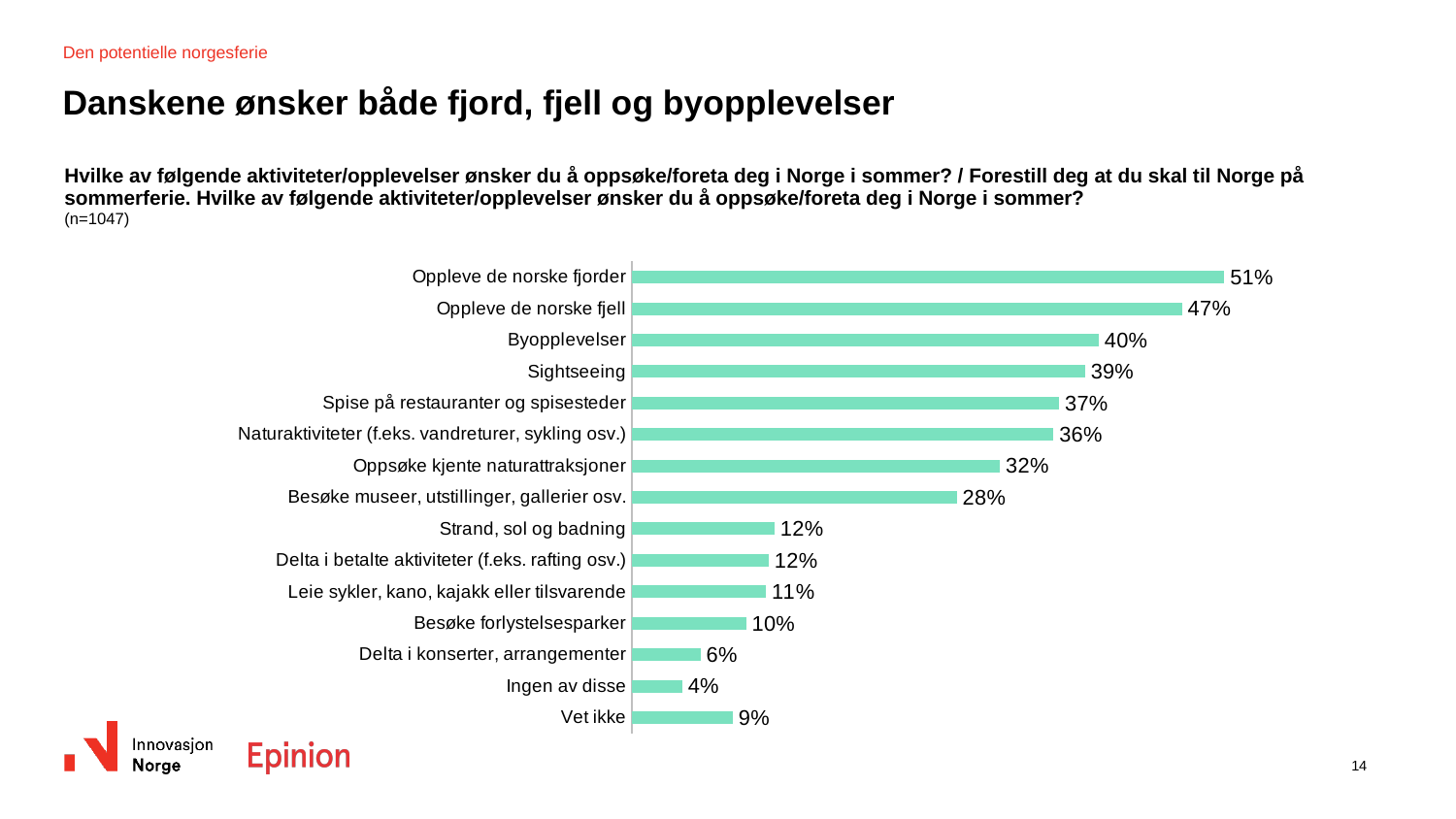
What is the difference between Sightseeing and Besøke forlystelsesparker? 29% How many categories are shown in the chart? 15 What type of chart is shown on the slide? Bar chart What percentage of respondents want to experience the Norwegian fjords (Oppleve de norske fjorder)? 51% What is the value for Vet ikke? 9% Which category has the lowest value? Ingen av disse What is the value for Byopplevelser? 40% Which is larger: Delta i konserter, arrangementer or Vet ikke? Vet ikke Which is larger: Spise på restauranter og spisesteder or Naturaktiviteter (f.eks. vandreturer, sykling osv.)? Spise på restauranter og spisesteder Which category has the highest value? Oppleve de norske fjorder What is the value for Besøke museer, utstillinger, gallerier osv.? 28% What is the difference between Oppleve de norske fjorder and Oppleve de norske fjell? 4%